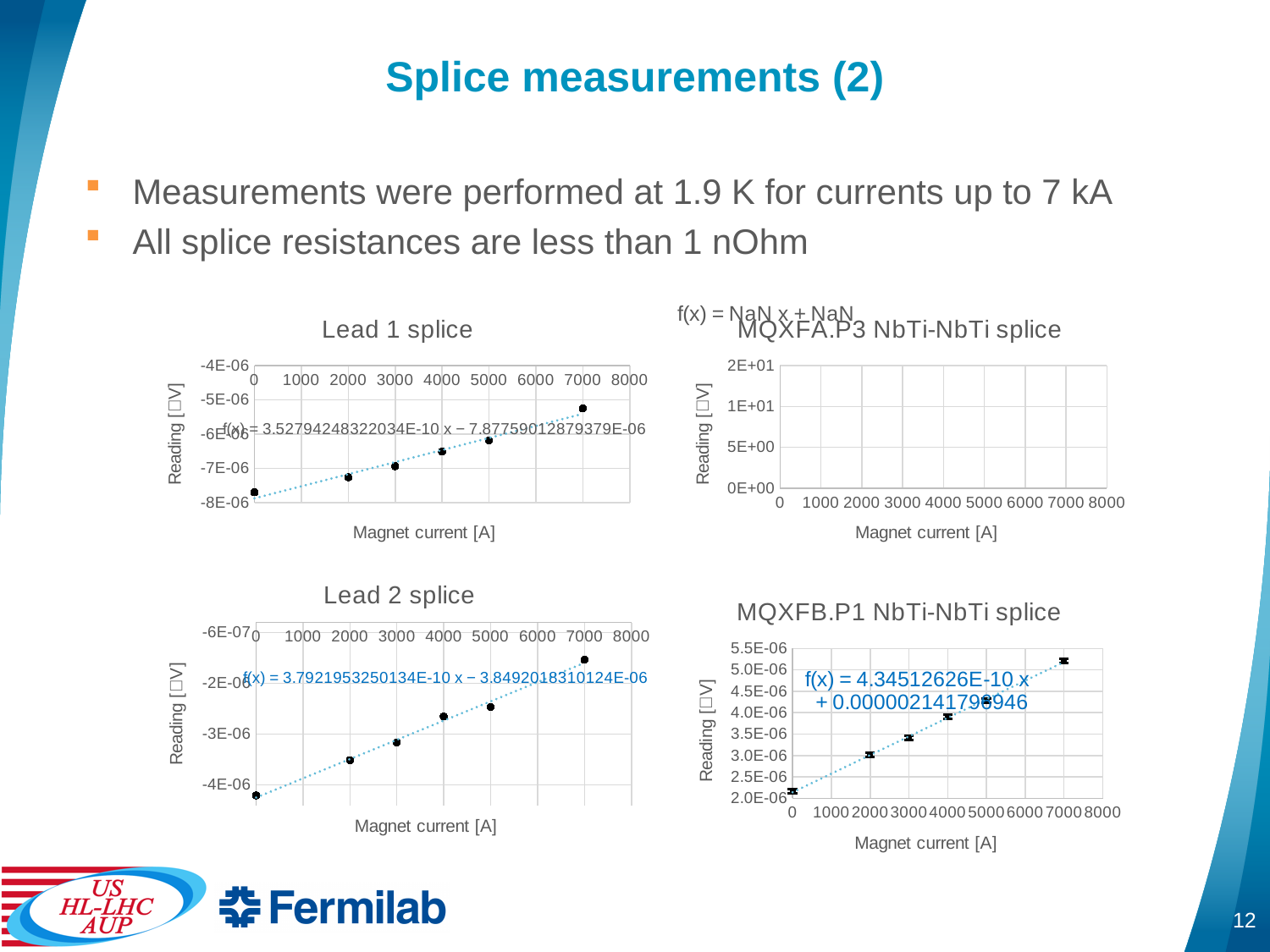
In the "MQXFB.P1 NbTi-NbTi splice" chart, which reading is larger: at 2000 A or at 5000 A? 5000 A What is the trend line equation shown on the "MQXFB.P1 NbTi-NbTi splice" chart? f(x) = 4.34512626E-10 x + 0.0000021417996946 In the "Lead 1 splice" chart, is the reading at 0 A greater or less than -7E-06? less How many data points are plotted in the "Lead 2 splice" chart? 6 What kind of chart is the "Lead 1 splice" chart? scatter chart In the "Lead 1 splice" chart, do the readings rise or fall as magnet current increases? rise In the "MQXFB.P1 NbTi-NbTi splice" chart, is the reading at 0 A greater or less than 2.5E-06? less What is the x-axis label of the "MQXFB.P1 NbTi-NbTi splice" chart? Magnet current [A] In the "Lead 1 splice" chart, is the reading at 7000 A greater or less than -6E-06? greater In the "Lead 2 splice" chart, at which magnet current is the reading highest? 7000 A